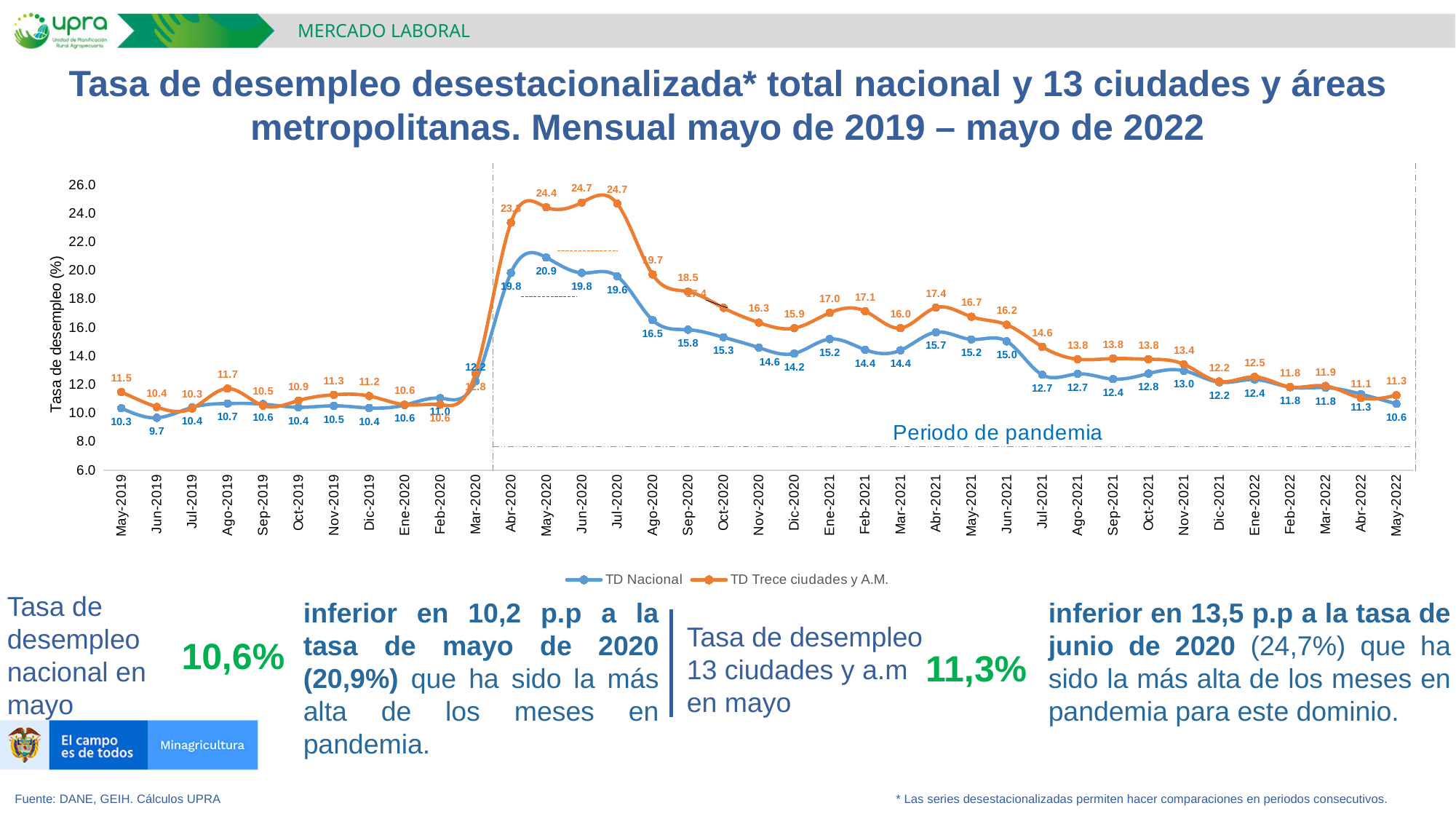
Which series has the higher value in Jun-2020, TD Nacional or TD Trece ciudades y A.M.? TD Trece ciudades y A.M. In which month does the TD Nacional series reach its highest value? May-2020 Is the TD Trece ciudades y A.M. value for Jul-2020 greater or less than 22.0? greater What is the difference between the TD Nacional values for May-2020 and May-2022? 10.3 What type of chart is shown on the slide? line chart What is the TD Trece ciudades y A.M. value for Jul-2021? 14.6 How many series does the legend list? 2 In which month does the TD Nacional series have its lowest value? Jun-2019 What label is written inside the dashed box on the right part of the chart? Periodo de pandemia What is the TD Nacional value for May-2020? 20.9 What is the TD Nacional value for May-2022? 10.6 How does the TD Nacional series change from May-2020 to May-2022? It falls